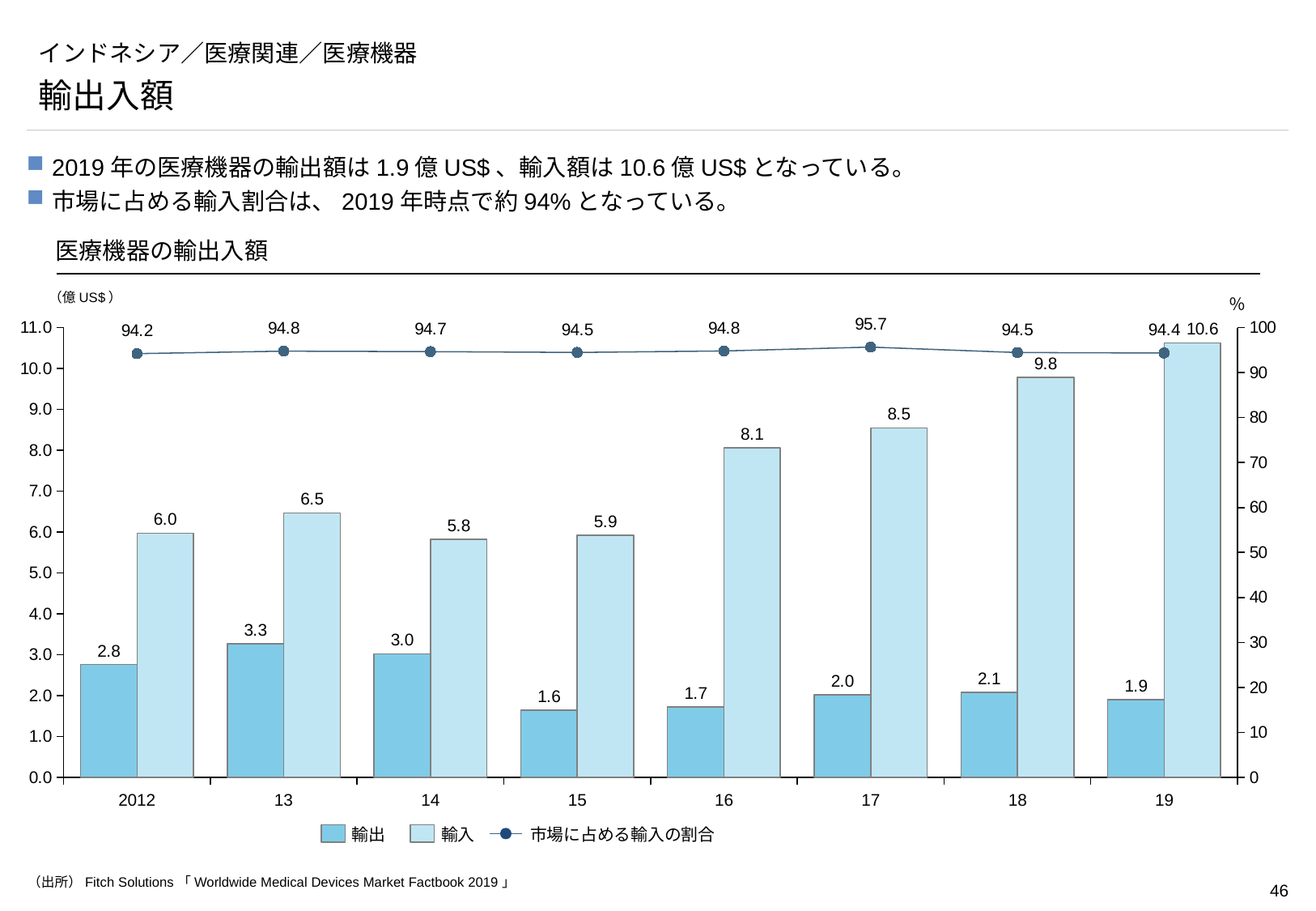
How many years are shown on the x axis? 8 Which year has the highest 輸出 (export) value? 13 What is the difference between the 輸入 and 輸出 values for 19? 8.7 What is the 輸入 (import) value for 19? 10.6 Do the 輸入 (import) values rise or fall from 15 to 19? Rise What is the 市場に占める輸入の割合 value for 17? 95.7 What is the unit shown for the left axis? 億 US$ What kind of chart is used for the 輸出 and 輸入 series? Bar chart How many series does the legend list? 3 Is the 輸入 (import) value for 16 larger than the 輸入 value for 15? Yes What is the 輸出 (export) value for 2012? 2.8 Which year has the lowest 輸入 (import) value? 14